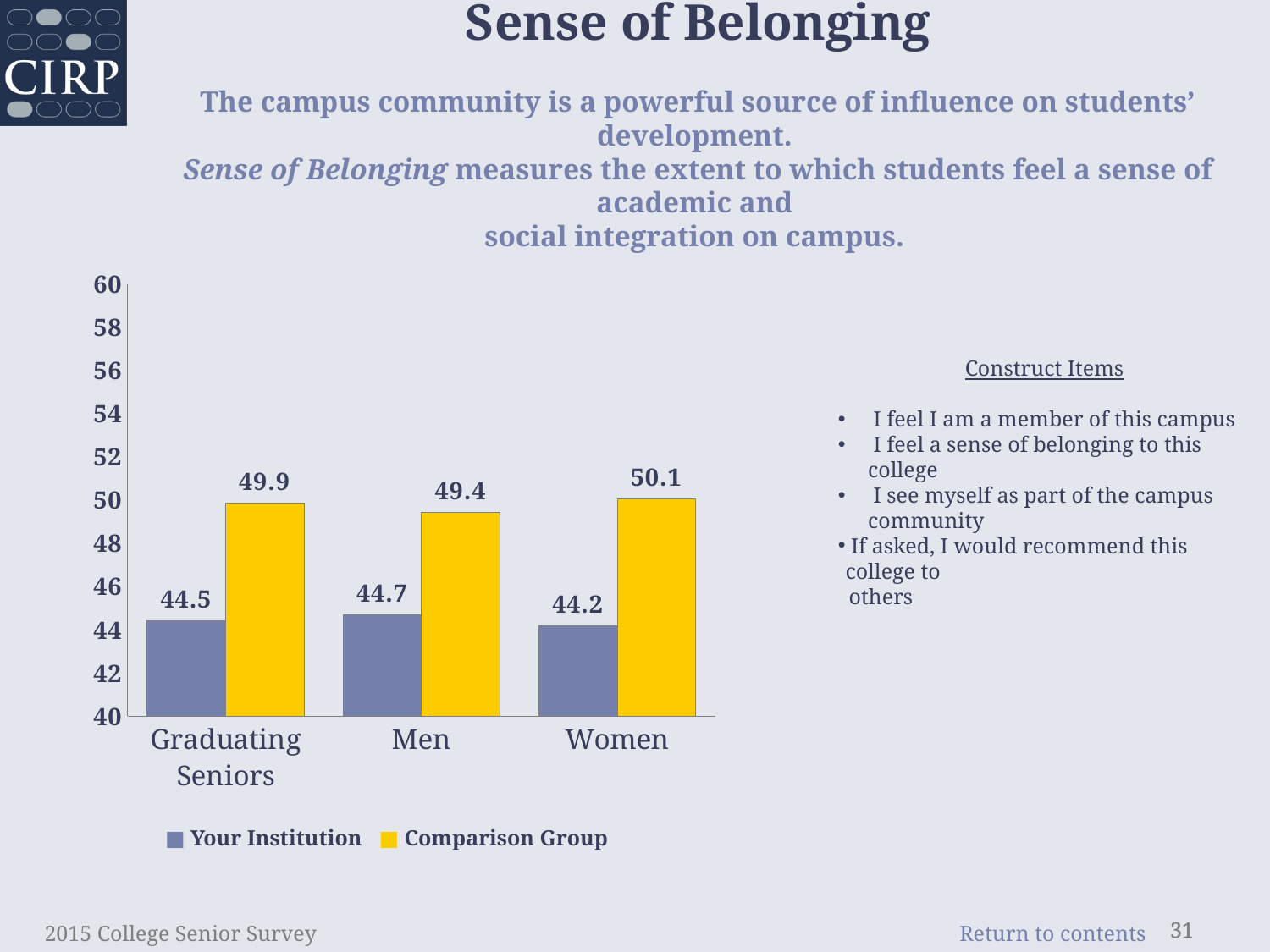
What kind of chart is shown on the slide? bar chart What is the difference between the Comparison Group and Your Institution values for Graduating Seniors? 5.4 What is the difference between the Comparison Group and Your Institution values for Women? 5.9 Which is larger for Men: Your Institution or Comparison Group? Comparison Group What is the value for Your Institution for Men? 44.7 Which category has the lowest Your Institution value? Women What is the value for Your Institution for Graduating Seniors? 44.5 How many series does the legend list? 2 What is the value for Comparison Group for Women? 50.1 Which category has the highest Comparison Group value? Women How many categories are shown on the x axis? 3 Is the Comparison Group value for Men greater or less than 48? greater